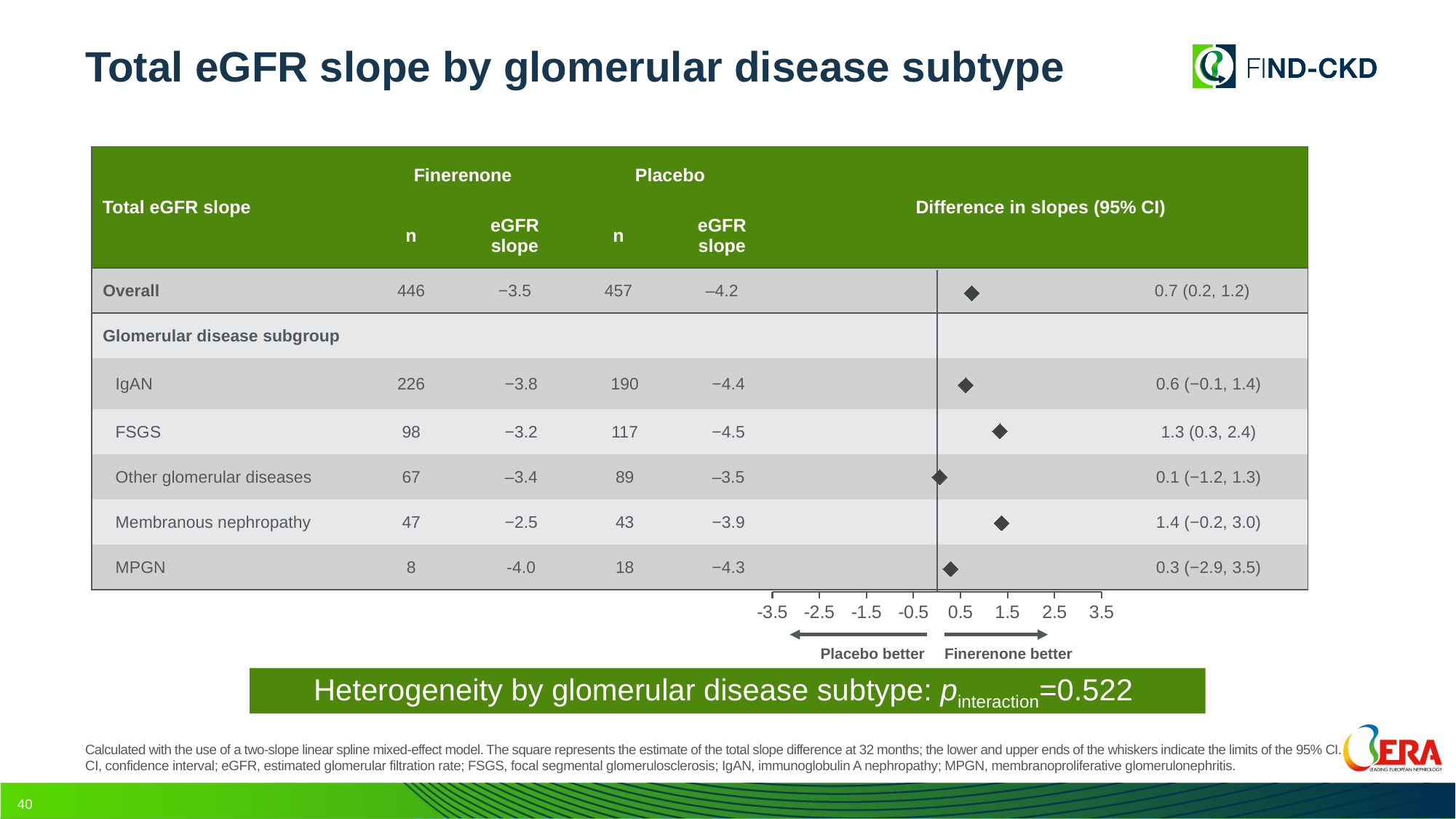
What is the point estimate of the difference in slopes for MPGN? 0.3 Which side of the forest plot axis is labelled 'Finerenone better'? The right side How many rows have a point estimate plotted in the forest plot? 6 What is the difference between the point estimates of the difference in slopes for FSGS and IgAN? 0.7 What is the difference in slopes (95% CI) shown for FSGS? 1.3 (0.3, 2.4) Is the point estimate of the difference in slopes for Membranous nephropathy greater or less than 0.5? greater What is the difference in slopes (95% CI) shown for the Overall group? 0.7 (0.2, 1.2) What is the finerenone eGFR slope for IgAN in the table? −3.8 Which glomerular disease subgroup has the lowest point estimate for the difference in slopes? Other glomerular diseases Which has a larger point estimate for the difference in slopes, FSGS or IgAN? FSGS Which glomerular disease subgroup has the highest point estimate for the difference in slopes? Membranous nephropathy What kind of chart is used to display the difference in slopes? Forest plot